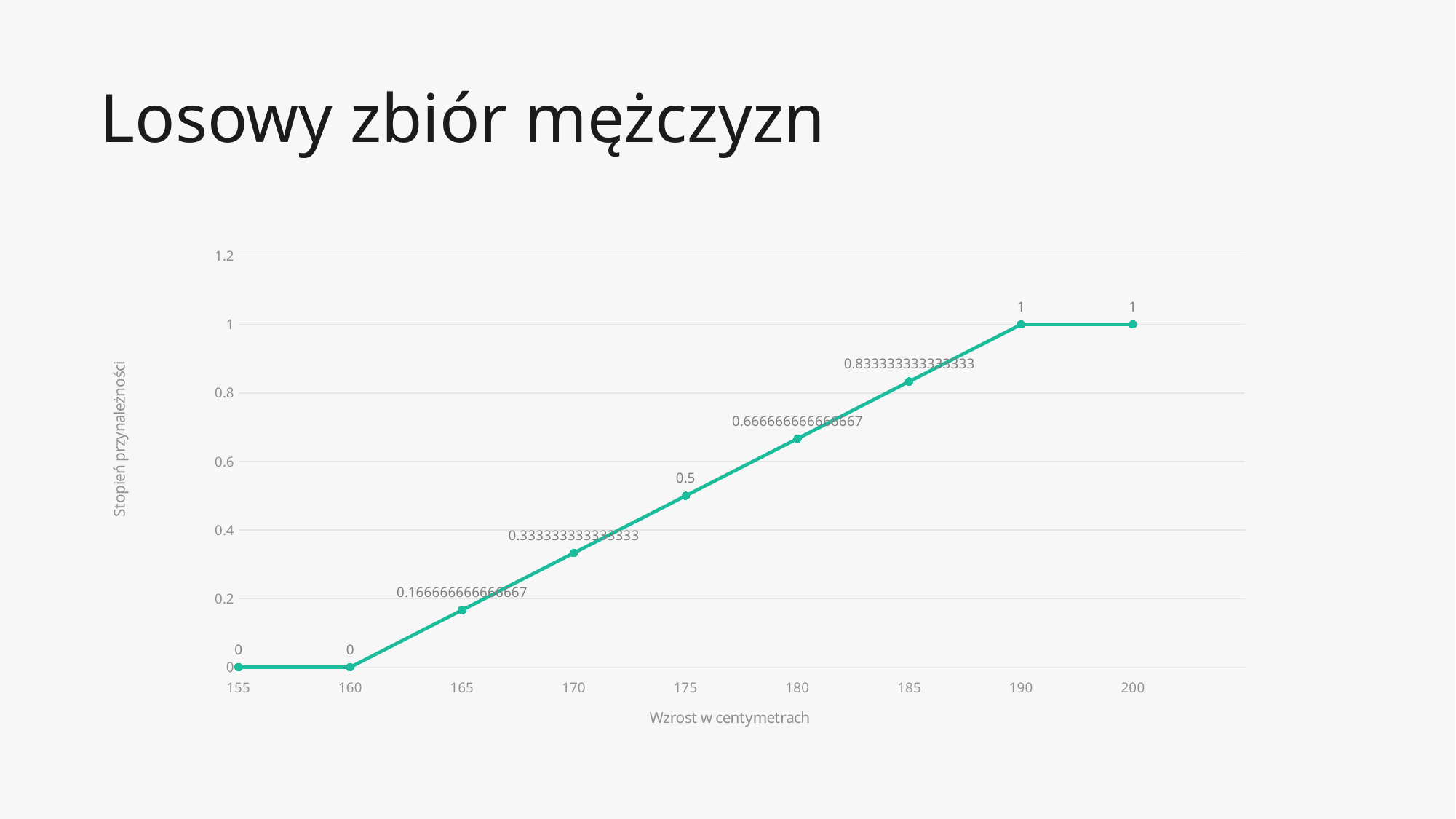
What type of chart is shown on the slide? line chart How many data points are plotted on the chart? 9 Is the value for 180 greater or less than 0.6? greater Which of the two values is larger: the one for 170 or the one for 180? 180 What is the value for 175 on the x axis? 0.5 What is the title of the slide containing the chart? Losowy zbiór mężczyzn What is the value for 165 on the x axis? 0.166666666666667 What is the value for 185 on the x axis? 0.833333333333333 Do the values generally rise or fall as height increases along the x axis? rise What is the label of the x axis? Wzrost w centymetrach What is the value for 190 on the x axis? 1 What is the value for 160 on the x axis? 0